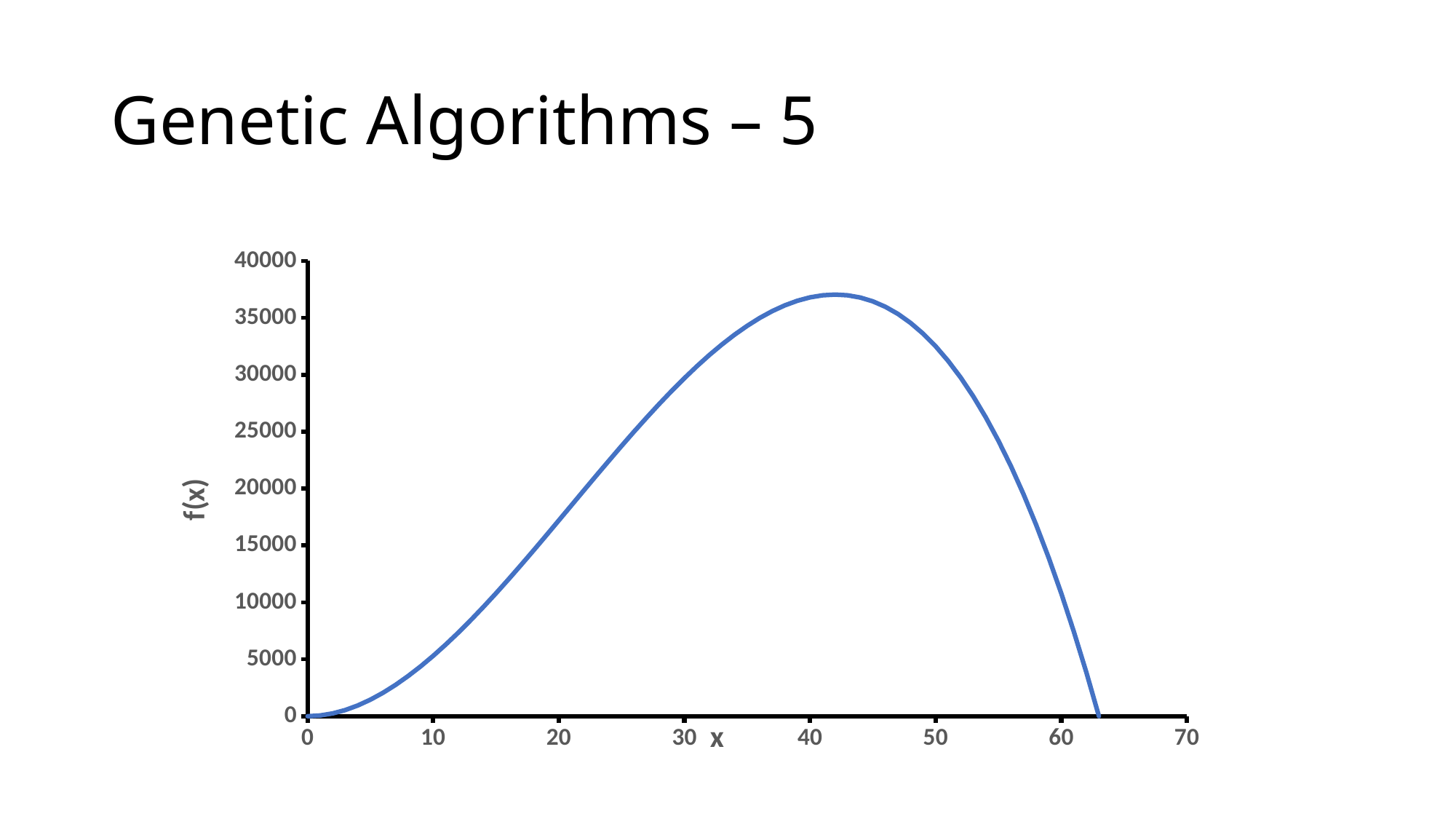
What kind of chart is shown on the slide? line chart Is the value of f(x) at x = 30 greater or less than 25000? greater Is the value of f(x) at x = 60 greater or less than 15000? less What is the value of f(x) at x = 0? 0 Is the value of f(x) at x = 20 greater or less than 15000? greater What is the label on the horizontal axis of the chart? x What is the label on the vertical axis of the chart? f(x) Which is larger, f(x) at x = 30 or f(x) at x = 60? f(x) at x = 30 How does f(x) change as x increases from 0 to 70? It rises to a peak between x = 40 and x = 50, then falls back to 0